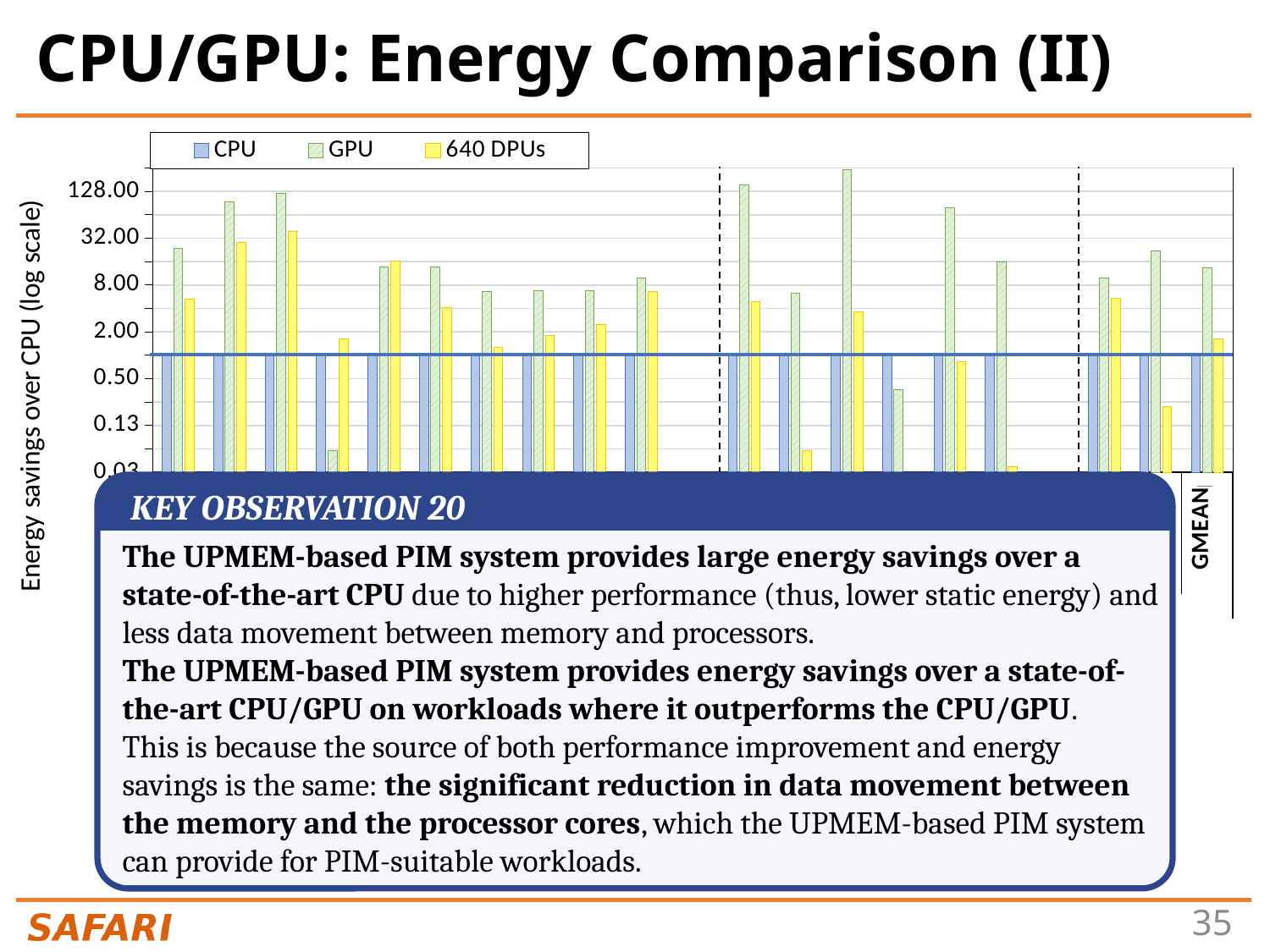
Is the GPU value for GMEAN greater or less than 8.00? greater What kind of chart is shown on the slide? bar chart For GMEAN, which is larger: the GPU value or the 640 DPUs value? GPU Is the 640 DPUs value for GMEAN greater or less than 2.00? less For GMEAN, which series has the highest value? GPU What is the label of the chart's vertical axis? Energy savings over CPU (log scale) Is the 640 DPUs value for GMEAN greater or less than 0.50? greater How many series does the chart legend list? 3 What are the three series named in the chart legend? CPU, GPU, 640 DPUs